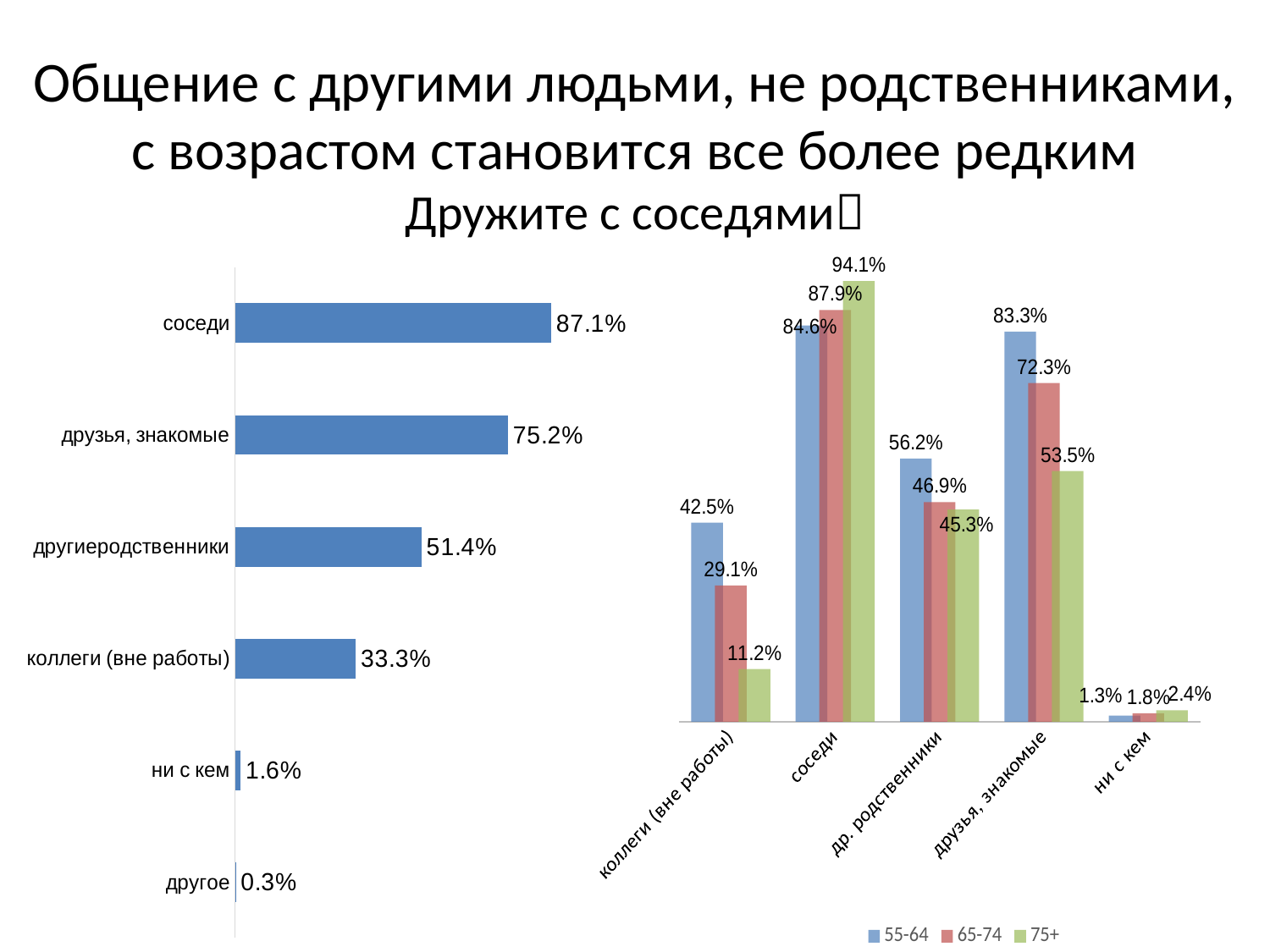
On the right chart, how many series does the legend list? 3 On the right chart, which category has the lowest values across all series? ни с кем On the left chart, what is the difference between соседи and друзья, знакомые? 11.9% On the left chart, how many categories are shown? 6 On the right chart, which is larger for др. родственники: the 65-74 value or the 75+ value? 65-74 On the left chart, which category has the lowest value? другое On the right chart, what is the difference between the 55-64 and 75+ values for коллеги (вне работы)? 31.3% On the right chart, what is the value for the 75+ series for соседи? 94.1% On the right chart, which series has the highest value for друзья, знакомые? 55-64 What kind of chart is the left chart? bar chart On the right chart, what is the value for the 55-64 series for коллеги (вне работы)? 42.5% On the left chart, what is the value for соседи? 87.1%